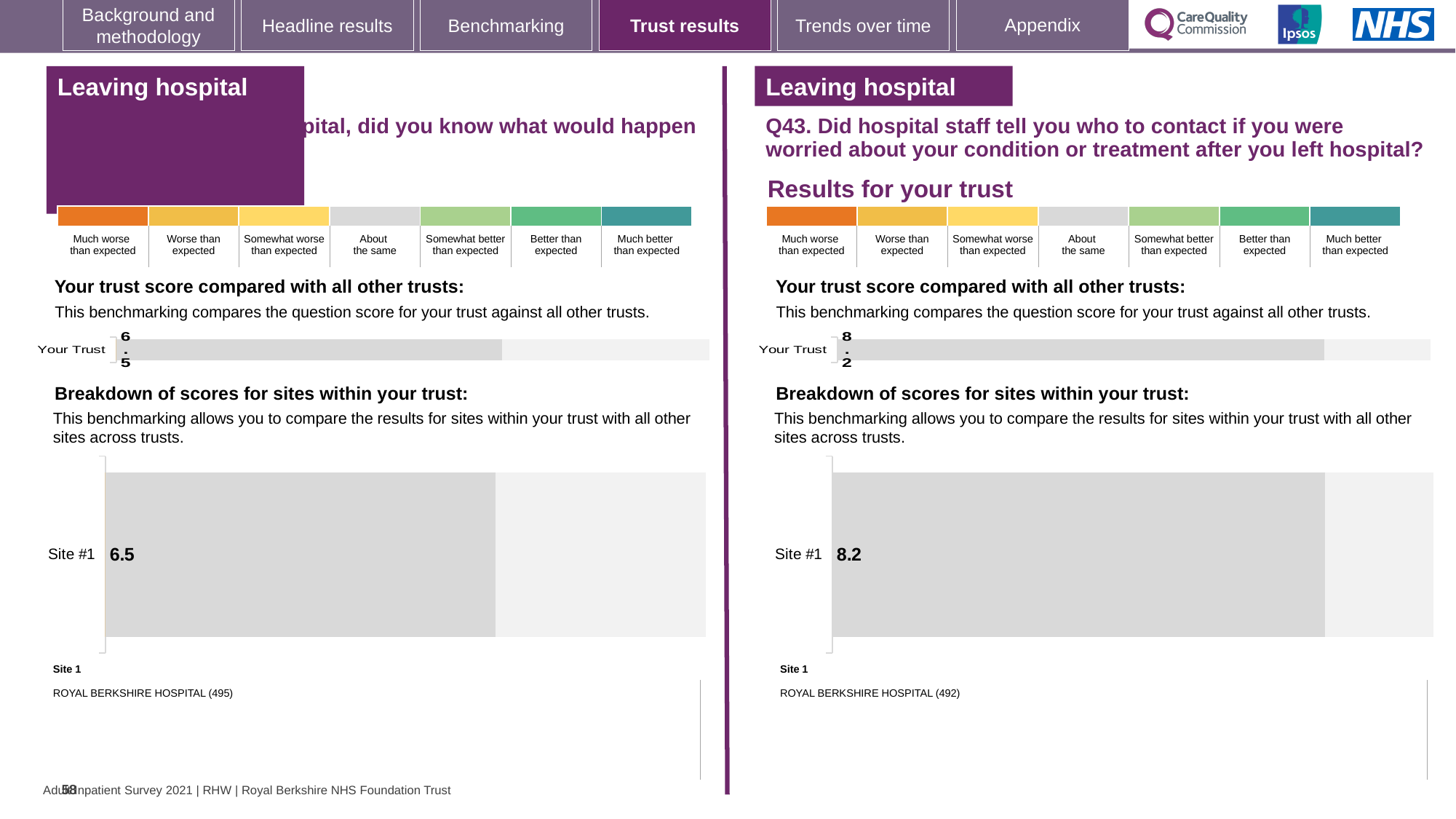
Which site is listed as Site 1 below the site breakdown chart on the left half of the slide? ROYAL BERKSHIRE HOSPITAL (495) In the site breakdown chart for Q43 on the right half of the slide, what is the score for Site #1? 8.2 Which is larger: the Your Trust score on the left half of the slide or the Your Trust score for Q43 on the right half? Q43 on the right half In the site breakdown chart on the left half of the slide, what is the score for Site #1? 6.5 On the right half of the slide (Q43), what is the score shown for Your Trust? 8.2 On the left half of the slide, what is the score shown for Your Trust? 6.5 How many sites are shown in the site breakdown chart for Q43 on the right half of the slide? 1 Which site is listed as Site 1 below the site breakdown chart on the right half of the slide? ROYAL BERKSHIRE HOSPITAL (492) How many sites are shown in the site breakdown chart on the left half of the slide? 1 What kind of chart is used to show the Site #1 score on the right half of the slide? Bar chart What is the difference between the Site #1 score for Q43 on the right half and the Site #1 score on the left half of the slide? 1.7